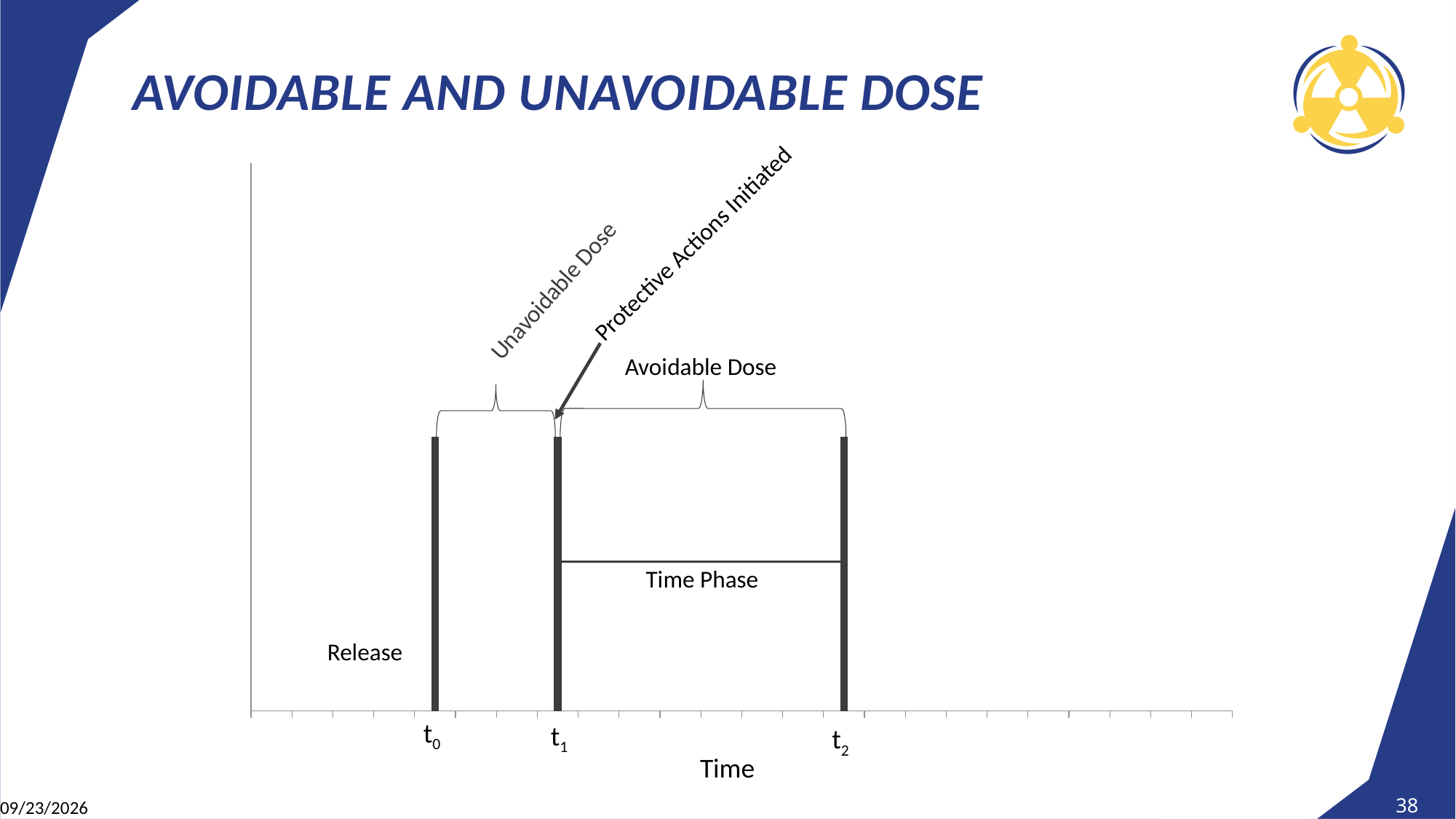
Which interval on the chart is labeled "Unavoidable Dose"? t0 to t1 Which interval on the chart is labeled "Avoidable Dose"? t1 to t2 How many vertical bars are drawn on the chart? 3 How many time points are marked on the x axis of the chart? 3 At which marked time point does the chart indicate protective actions are initiated? t1 What is the label on the x axis of the chart? Time What label is placed at the first vertical bar (t0) on the chart? Release